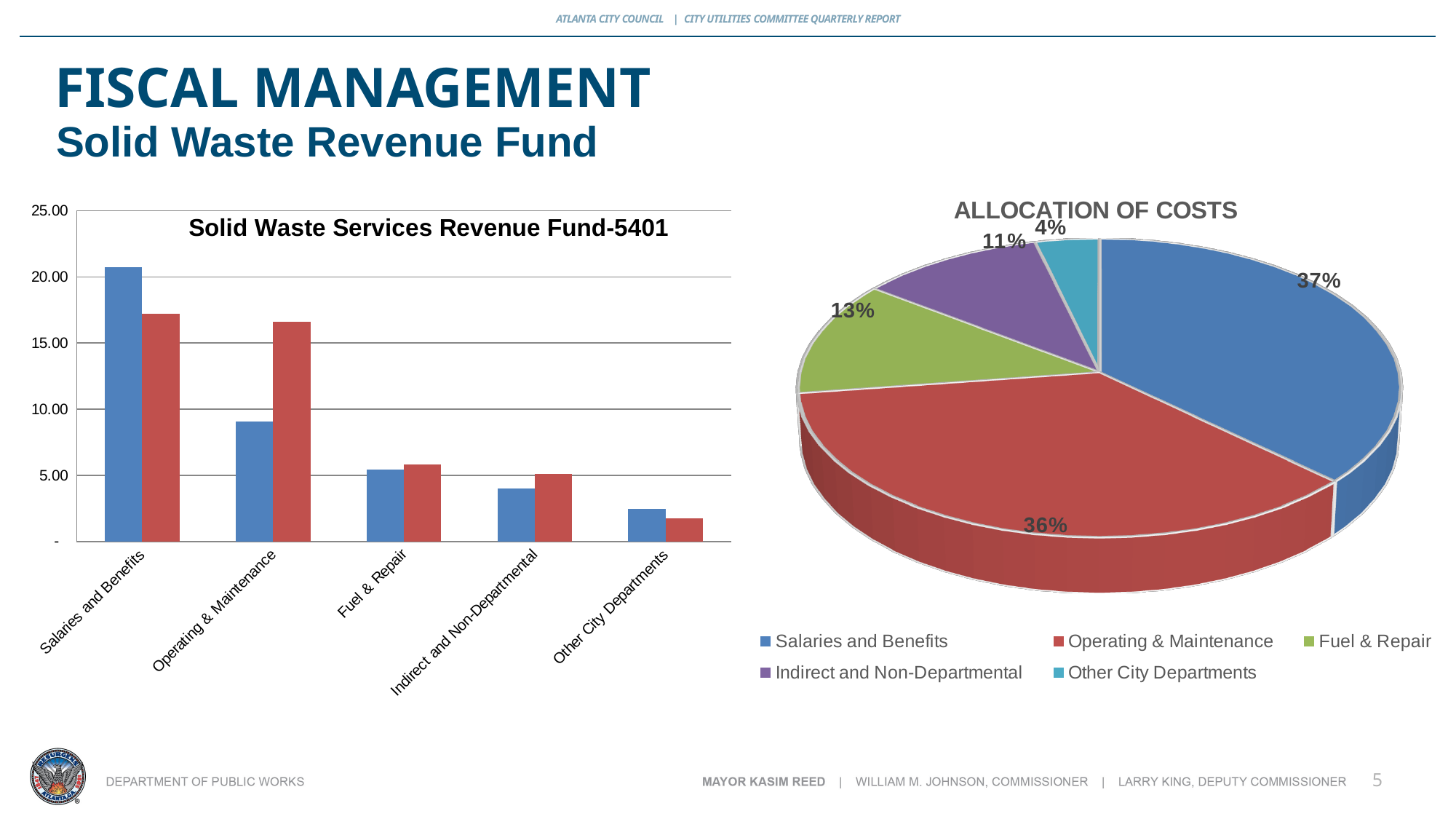
In the 'Solid Waste Services Revenue Fund-5401' bar chart, is the blue bar for Salaries and Benefits greater or less than 20.00? greater What kind of chart is the 'Solid Waste Services Revenue Fund-5401' chart on the left? bar chart In the 'ALLOCATION OF COSTS' pie chart, which category has the smallest share? Other City Departments In the 'Solid Waste Services Revenue Fund-5401' bar chart, which is larger for Operating & Maintenance, the blue bar or the red bar? the red bar In the 'ALLOCATION OF COSTS' pie chart, which category has the largest share? Salaries and Benefits How many categories does the legend of the 'ALLOCATION OF COSTS' pie chart list? 5 In the 'ALLOCATION OF COSTS' pie chart, what share is labelled for Salaries and Benefits? 37% In the 'Solid Waste Services Revenue Fund-5401' bar chart, is the blue bar for Operating & Maintenance greater or less than 10.00? less What kind of chart is the 'ALLOCATION OF COSTS' chart on the right? pie chart In the 'ALLOCATION OF COSTS' pie chart, what is the difference between the Operating & Maintenance share and the Indirect and Non-Departmental share? 25% In the 'Solid Waste Services Revenue Fund-5401' bar chart, how many categories are shown on the x axis? 5 In the 'ALLOCATION OF COSTS' pie chart, what share is labelled for Fuel & Repair? 13%